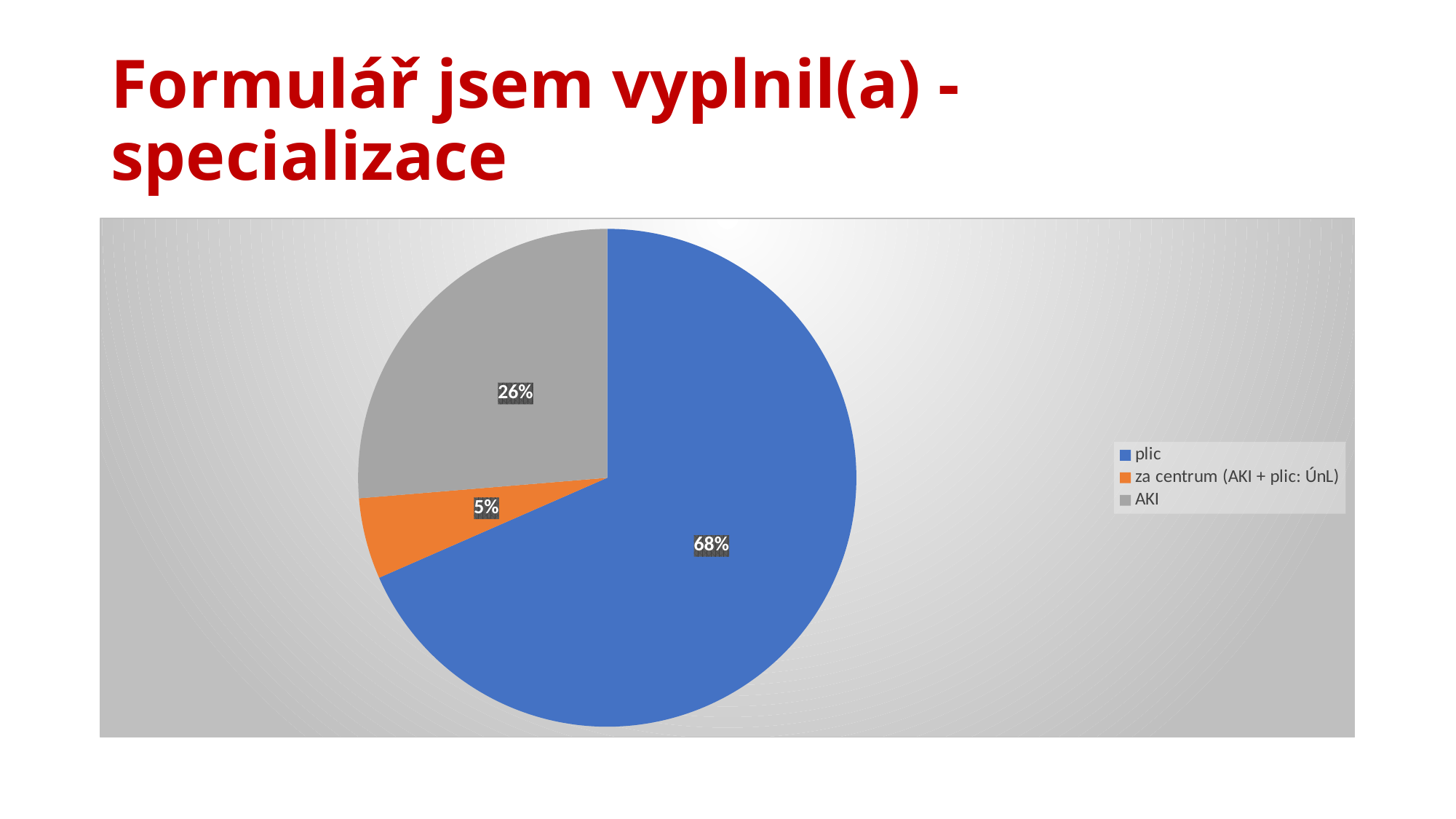
What share of the pie does the 'AKI' slice represent? 26% Which category has the smallest slice of the pie? za centrum (AKI + plic: ÚnL) How many slices does the pie chart have? 3 How many entries does the legend list? 3 What is the difference in percentage points between the 'plic' slice and the 'AKI' slice? 42 What share of the pie does the 'plic' slice represent? 68% What kind of chart is shown on the slide? pie chart What share of the pie does the 'za centrum (AKI + plic: ÚnL)' slice represent? 5% Which is larger, the 'AKI' slice or the 'za centrum (AKI + plic: ÚnL)' slice? AKI What colour is the 'AKI' slice in the pie chart? grey Which category has the largest slice of the pie? plic What is the difference in percentage points between the 'AKI' slice and the 'za centrum (AKI + plic: ÚnL)' slice? 21